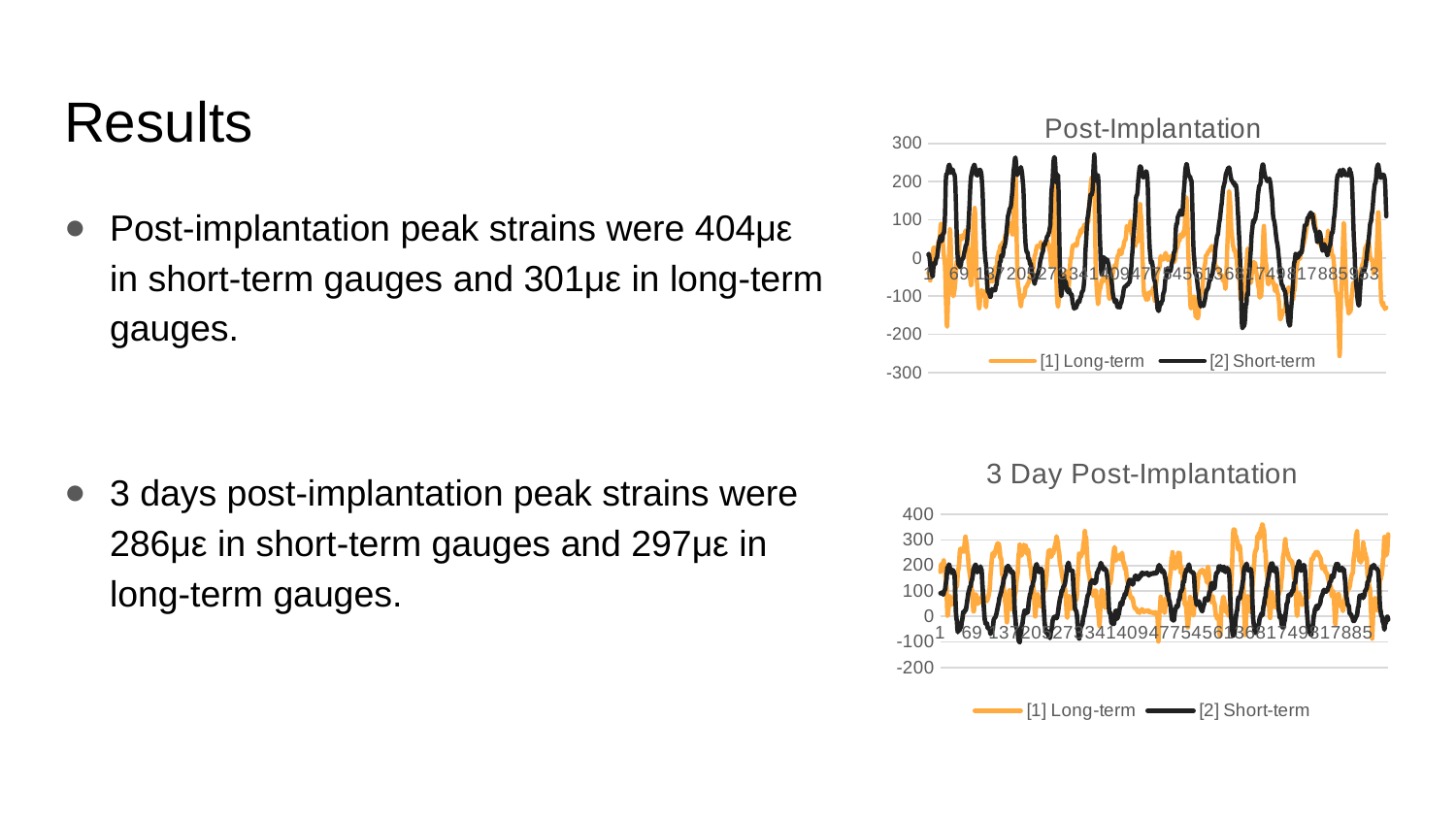
In the Post-Implantation chart, which colour is used for the [2] Short-term series? Black In the 3 Day Post-Implantation chart, which series is drawn in orange? [1] Long-term In the Post-Implantation chart, are the highest peaks of the [2] Short-term series greater or less than 200? greater In the Post-Implantation chart, which series reaches the higher peak value, [1] Long-term or [2] Short-term? [2] Short-term In the 3 Day Post-Implantation chart, which series reaches the higher peak value, [1] Long-term or [2] Short-term? [1] Long-term What kind of chart is the 3 Day Post-Implantation chart? Line chart How many series does the legend of the Post-Implantation chart list? 2 In the 3 Day Post-Implantation chart, are the peaks of the [2] Short-term series greater or less than 300? less In the Post-Implantation chart, is the lowest value of the [1] Long-term series greater or less than -200? less What kind of chart is the Post-Implantation chart? Line chart How many series does the legend of the 3 Day Post-Implantation chart list? 2